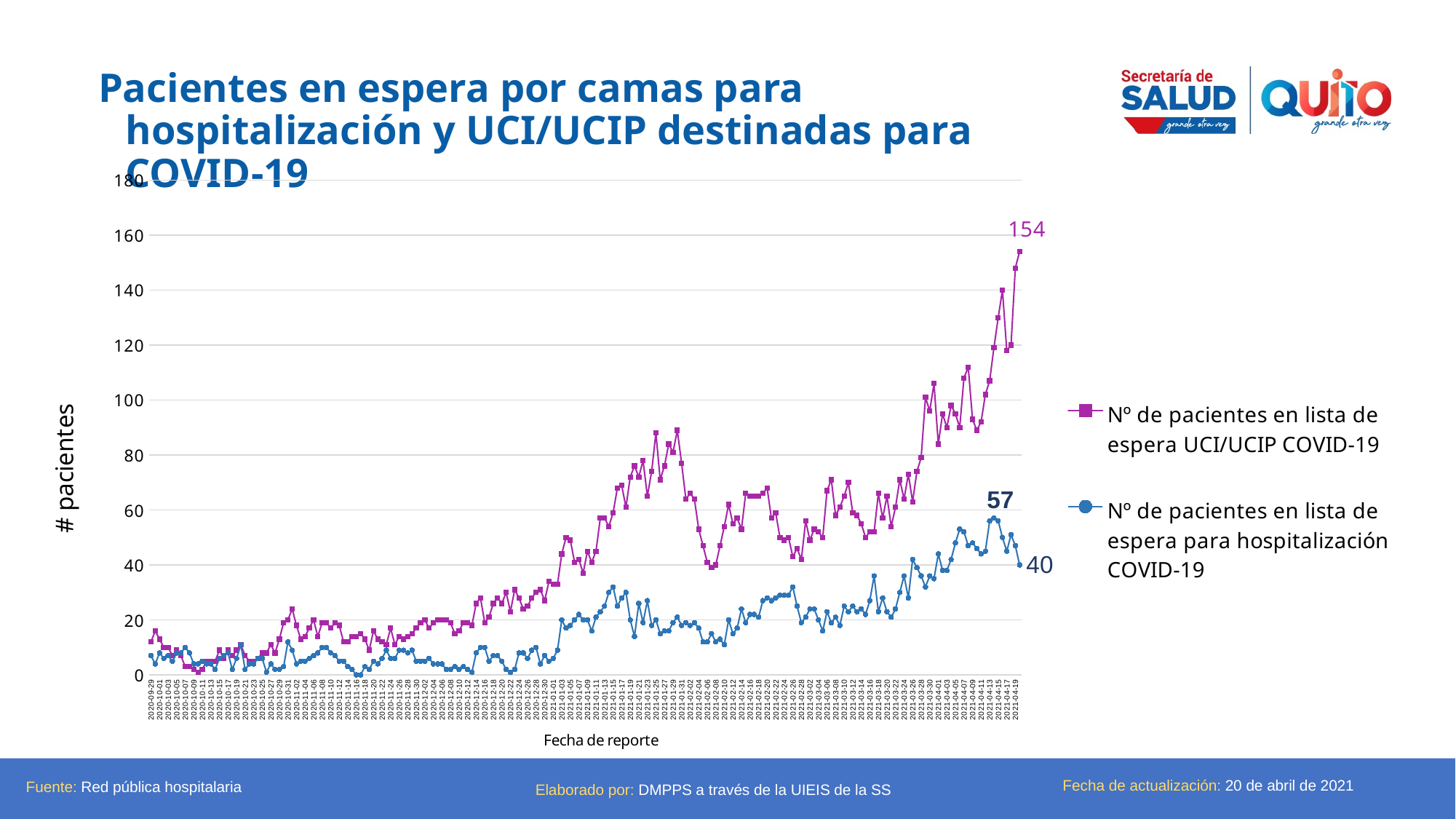
Which series reaches the highest value on the chart? Nº de pacientes en lista de espera UCI/UCIP COVID-19 Overall, does the UCI/UCIP series rise or fall from the start of the period to the end? rise By how much does the labelled peak of the hospitalización series (57) exceed its final labelled value (40)? 17 What kind of chart is shown on the slide? line chart What is the title of the vertical axis? # pacientes What is the labelled peak value of the series 'Nº de pacientes en lista de espera para hospitalización COVID-19'? 57 What is the difference between the final labelled values of the UCI/UCIP series (154) and the hospitalización series (40)? 114 Is the highest value reached by the hospitalización series greater or less than 60? less What is the last labelled value of the series 'Nº de pacientes en lista de espera UCI/UCIP COVID-19'? 154 What is the last labelled value of the series 'Nº de pacientes en lista de espera para hospitalización COVID-19'? 40 How many series does the legend list? 2 At the last reported date, which series has the higher value: UCI/UCIP or hospitalización? Nº de pacientes en lista de espera UCI/UCIP COVID-19